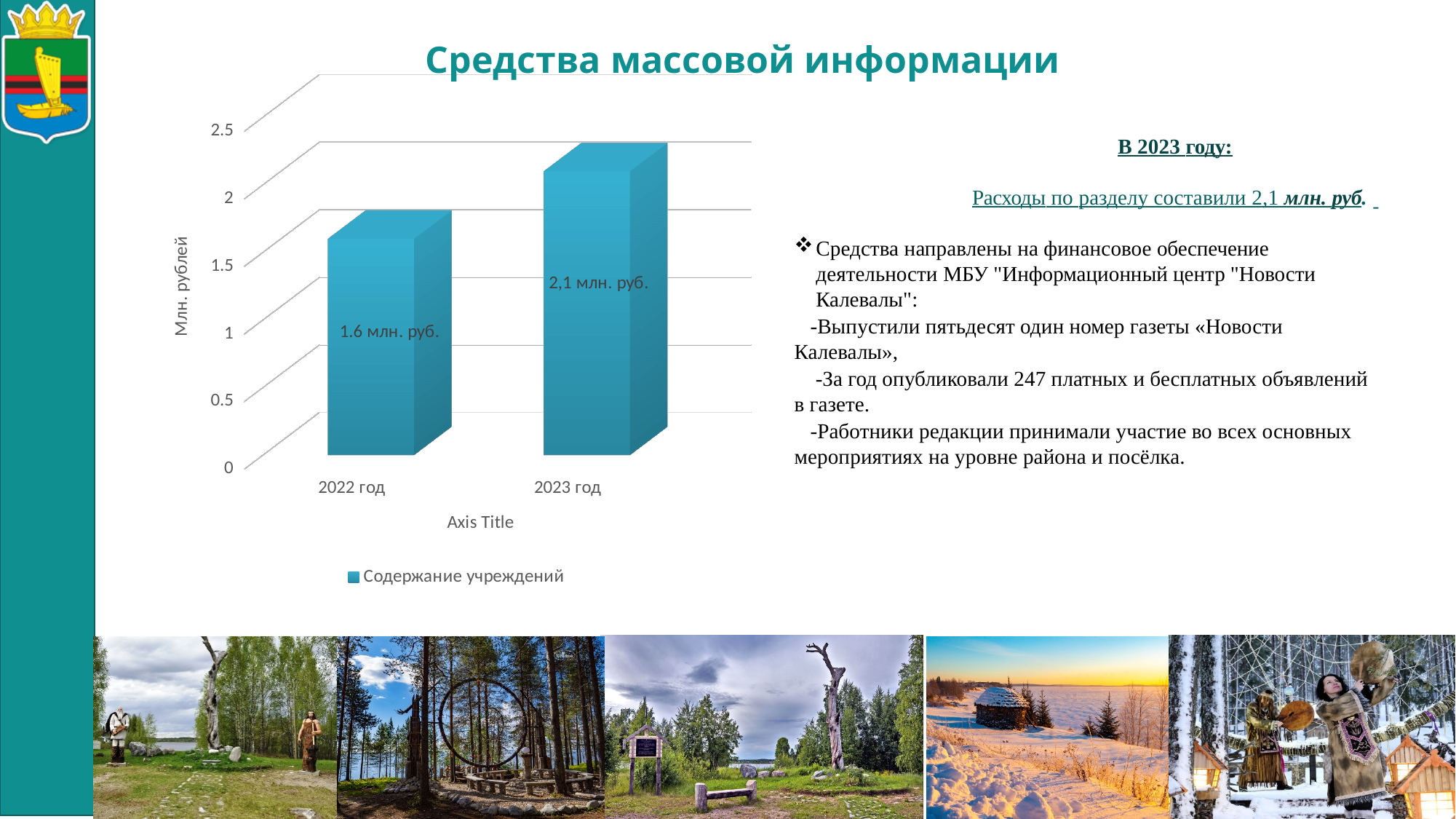
How many series does the chart legend list? 1 Which year has the higher value? 2023 год Is the value for 2022 год larger or smaller than the value for 2023 год? smaller What is the value shown for 2022 год? 1.6 млн. руб. What kind of chart is shown on the slide? bar chart Is the value for 2023 год greater or less than 2.5? less What is the value shown for 2023 год? 2,1 млн. руб. Is the value for 2022 год greater or less than 1.5? greater How many categories are shown on the x axis of the chart? 2 What is the name of the series in the chart legend? Содержание учреждений By how much does the value for 2023 год exceed the value for 2022 год? 0.5 млн. руб. Which year has the lower value? 2022 год